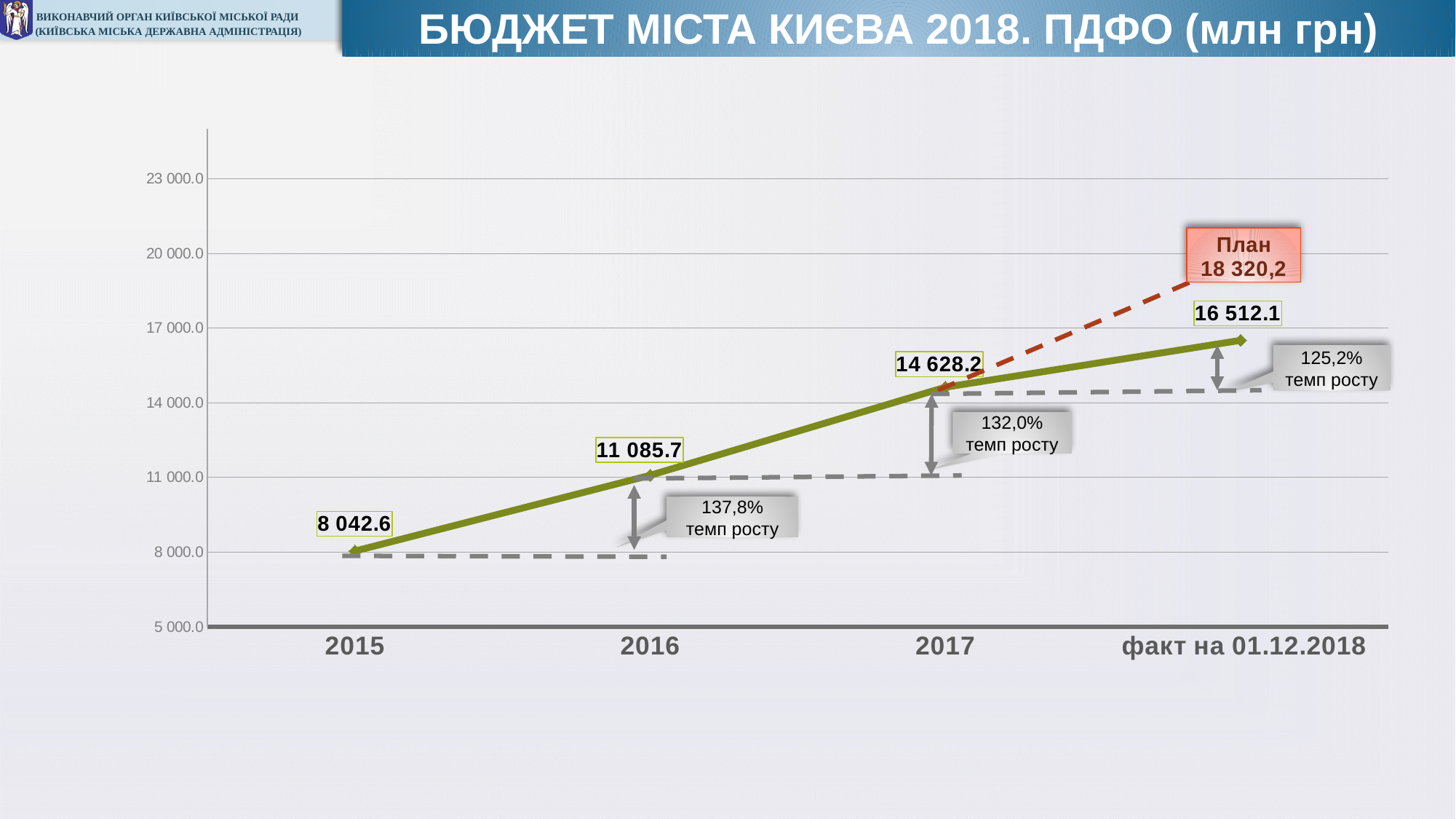
What is the PDFO value for 2016? 11 085.7 How many data points are plotted on the solid line? 4 What is the PDFO value for 2015? 8 042.6 What is the PDFO value for 2017? 14 628.2 Which is larger, the value for 2017 or the value for 'факт на 01.12.2018'? факт на 01.12.2018 What is the difference between the 2017 value and the 2016 value? 3 542.5 What is the value labelled for 'факт на 01.12.2018'? 16 512.1 What is the difference between the 2016 value and the 2015 value? 3 043.1 What growth rate (темп росту) is shown between 2016 and 2017? 132,0% Which year has the lowest PDFO value on the chart? 2015 What is the planned (План) value shown on the chart? 18 320,2 Do the values rise or fall from 2015 to 'факт на 01.12.2018'? rise